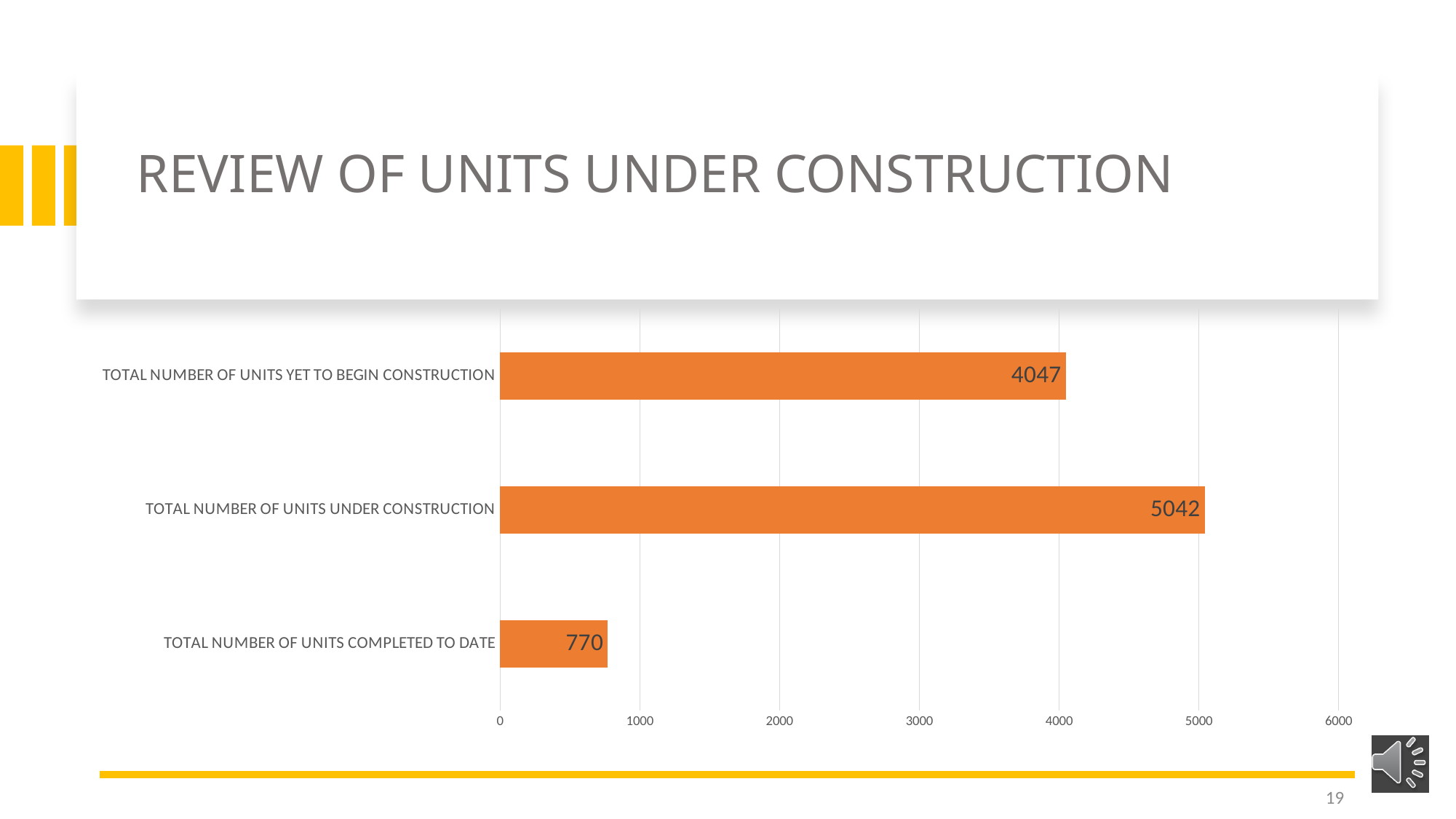
What is the total number of units yet to begin construction? 4047 What is the total number of units completed to date? 770 Is the value for total number of units under construction greater or less than 5000? greater What is the difference between the number of units under construction and the number of units completed to date? 4272 How many categories are shown in the chart? 3 What is the difference between the number of units under construction and the number of units yet to begin construction? 995 What is the title of the slide containing the chart? Review of Units Under Construction Which category has the lowest value? Total number of units completed to date Which is larger: the number of units yet to begin construction or the number of units completed to date? Total number of units yet to begin construction Which category has the highest value? Total number of units under construction What is the total number of units under construction? 5042 What kind of chart is shown on the slide? Bar chart